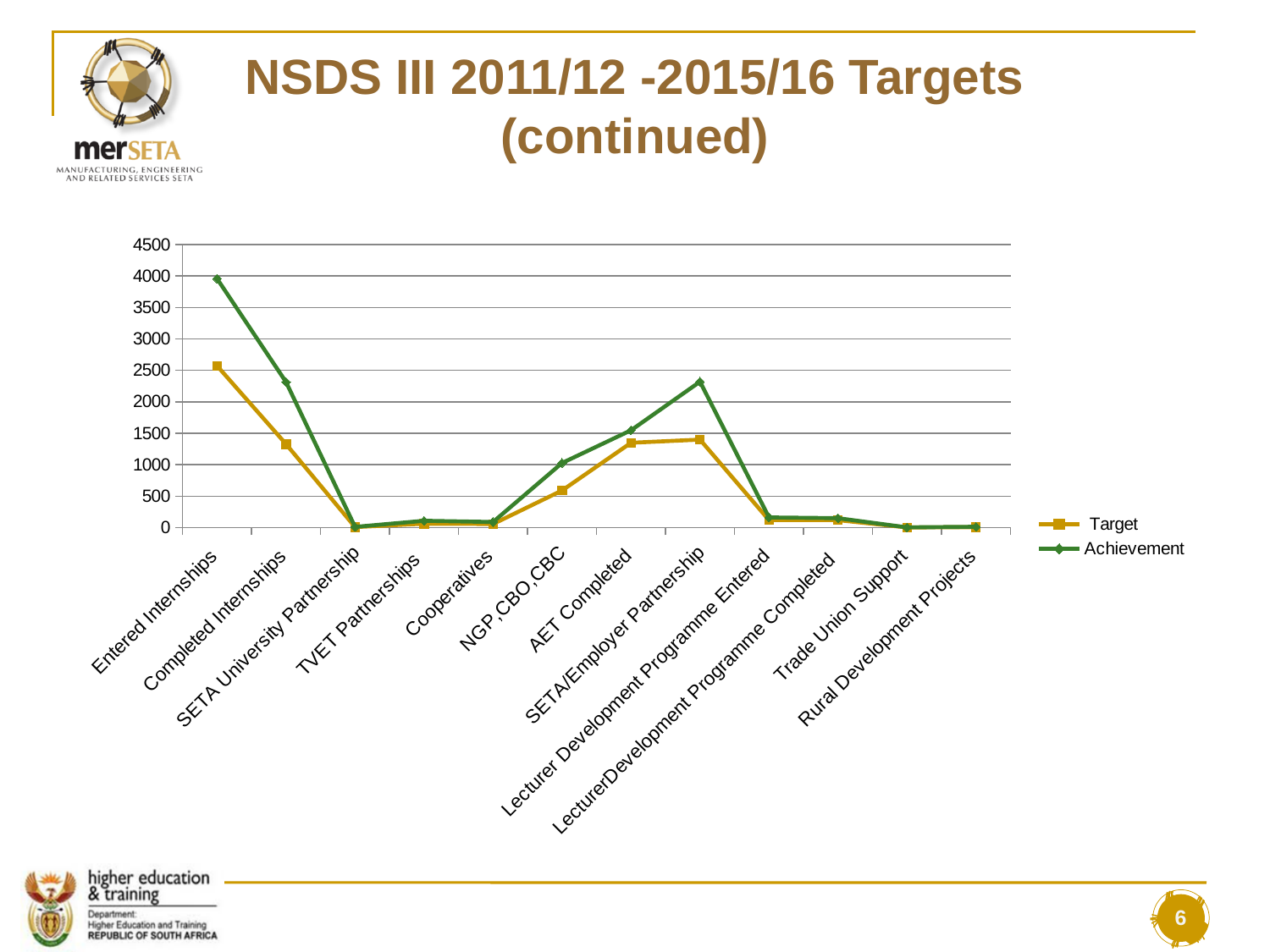
Is the Target value for NGP,CBO,CBC greater or less than 1000? less What kind of chart is shown on the slide? line chart Is the Achievement value for Entered Internships greater or less than 3500? greater Which series is drawn in green? Achievement Do the Target values rise or fall from Entered Internships to SETA University Partnership? fall For Completed Internships, which is larger, the Target or the Achievement value? Achievement How many categories are plotted along the x axis? 12 Which category has the highest Achievement value? Entered Internships How many series does the legend list? 2 Which category has the highest Target value? Entered Internships Is the Target value for Entered Internships greater or less than 3000? less